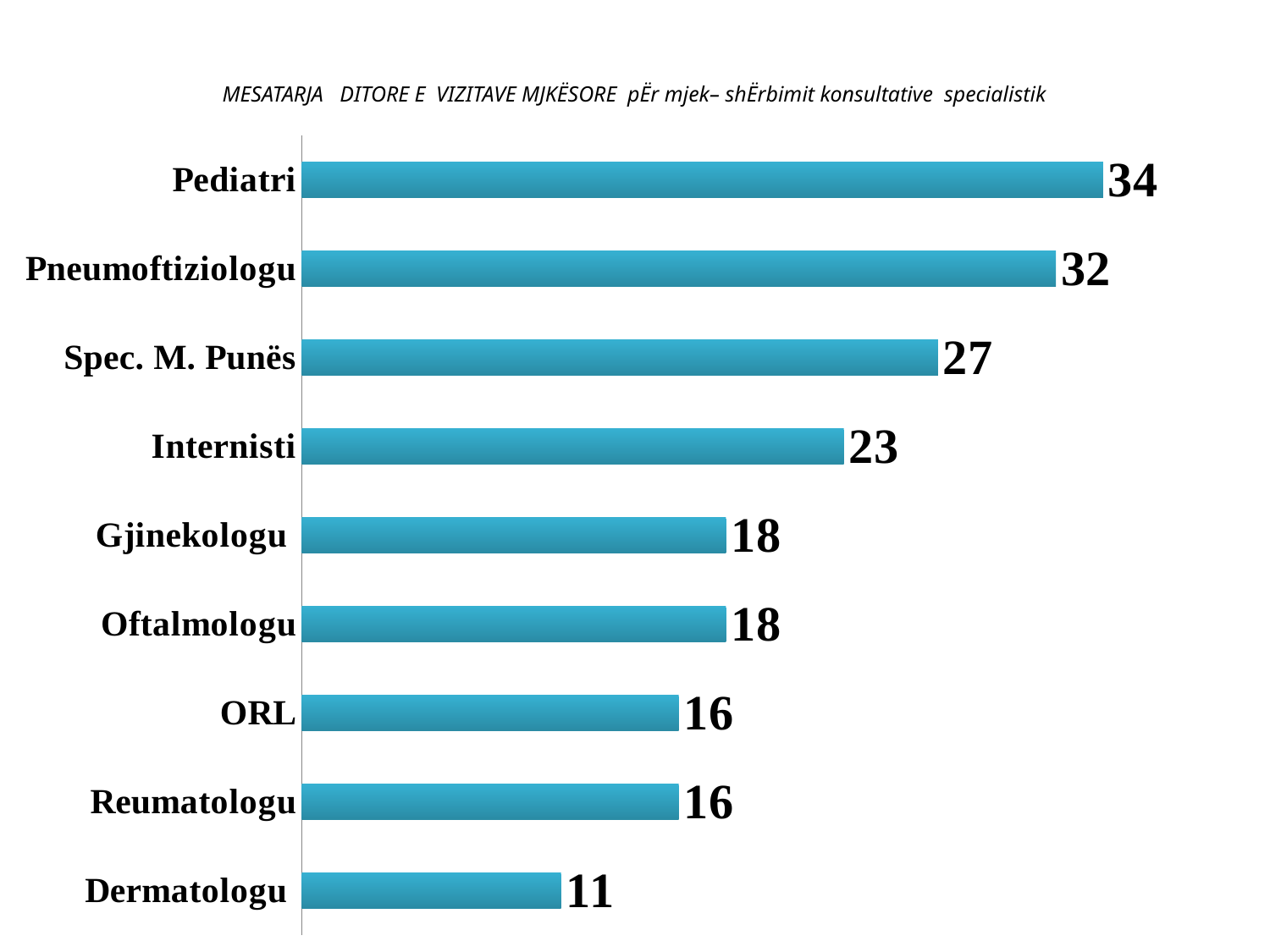
What is the difference between the values for Spec. M. Punës and Dermatologu? 16 Which category has the lowest value? Dermatologu What colour are the bars in the chart? blue What is the value for Internisti? 23 What is the value for Pediatri? 34 Which is larger, the value for Internisti or the value for Gjinekologu? Internisti Which category has the highest value? Pediatri What is the value for ORL? 16 What is the value for Dermatologu? 11 How many categories are shown in the chart? 9 What is the difference between the values for Pediatri and Pneumoftiziologu? 2 What kind of chart is shown on the slide? bar chart